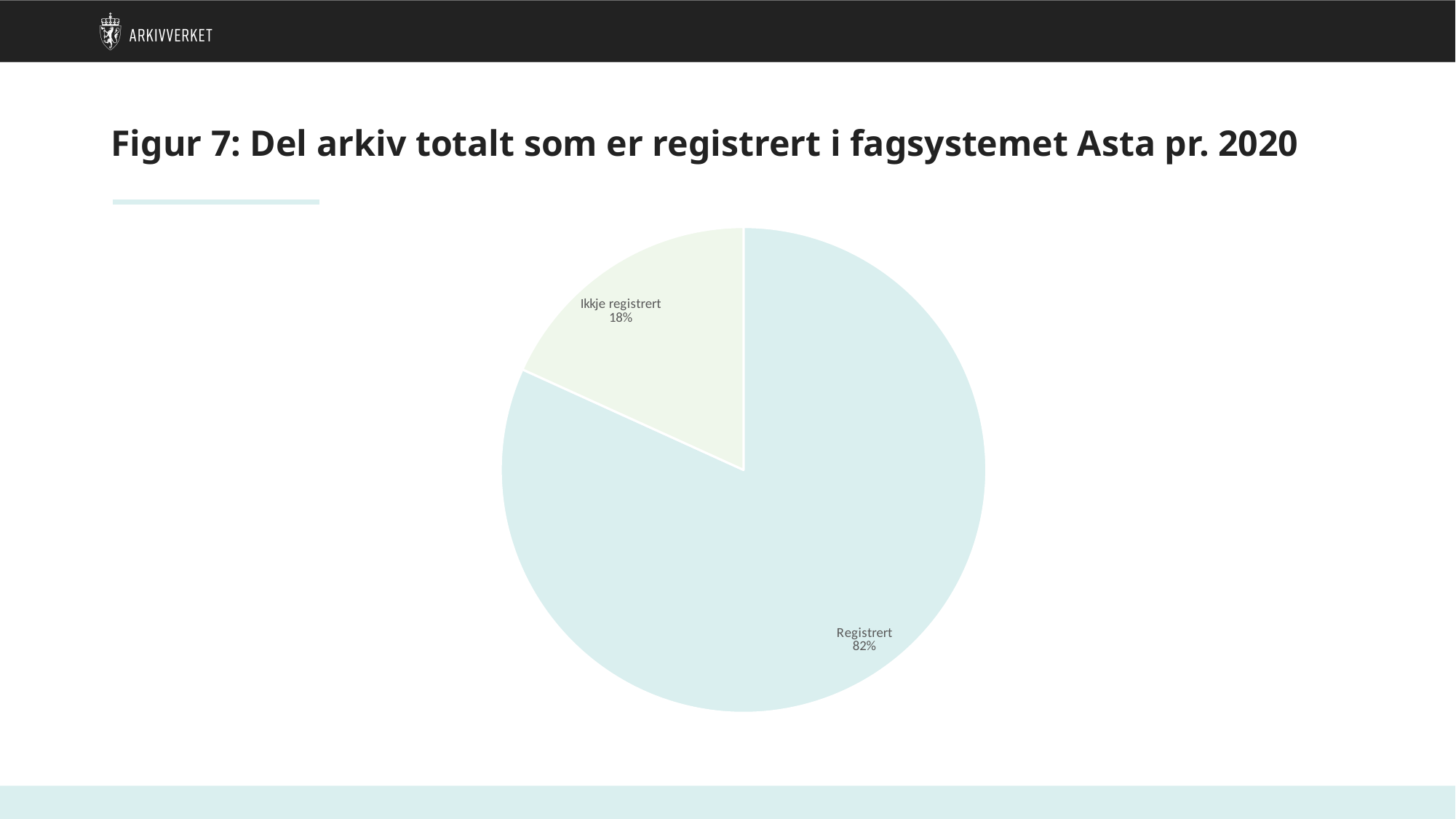
Which slice of the pie is the smallest? Ikkje registrert What is the total of the two slice percentages shown on the pie chart? 100% What is the title of the slide containing the pie chart? Figur 7: Del arkiv totalt som er registrert i fagsystemet Asta pr. 2020 How many slices does the pie chart have? 2 What kind of chart is shown on the slide? pie chart Which slice of the pie is coloured light blue? Registrert What share of the pie is labelled "Registrert"? 82% What is the difference in percentage points between the "Registrert" and "Ikkje registrert" slices? 64 Which is larger, the "Registrert" slice or the "Ikkje registrert" slice? Registrert What share of the pie is labelled "Ikkje registrert"? 18% Which slice of the pie is the largest? Registrert